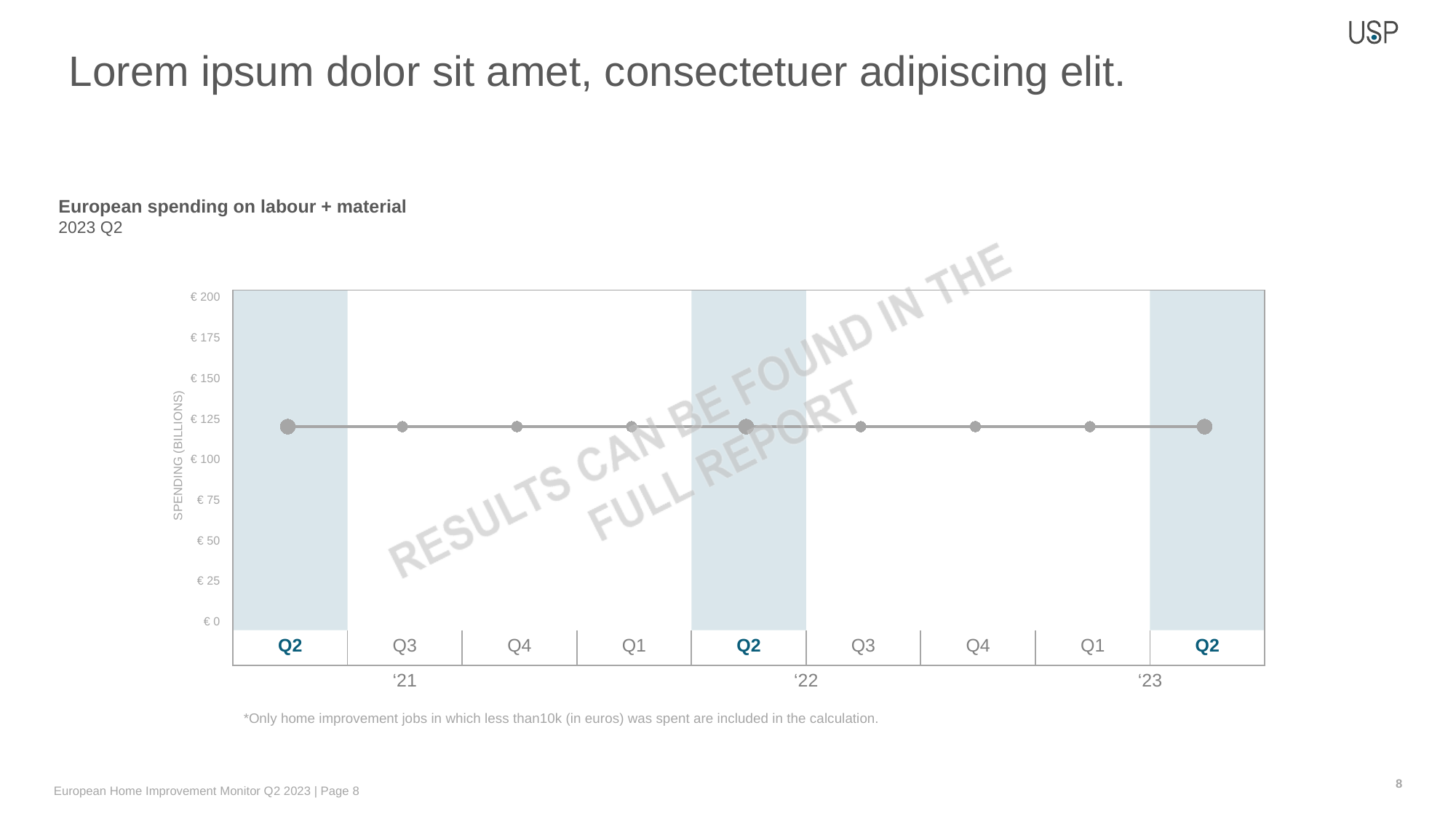
Do the values rise, fall, or stay flat from Q2 '21 to Q2 '23? stay flat How many data points are plotted on the line? 9 What kind of chart is shown on the slide? line chart Is the value for Q2 '21 greater or less than € 150? less What is the title of the chart? European spending on labour + material What is the highest value shown on the vertical axis? € 200 What is the label on the vertical axis? SPENDING (BILLIONS) Is the value for Q4 '22 greater or less than € 75? greater Which quarter is the first category on the x axis? Q2 Is the value for Q3 '21 greater or less than € 175? less How many years are labelled along the x axis? 3